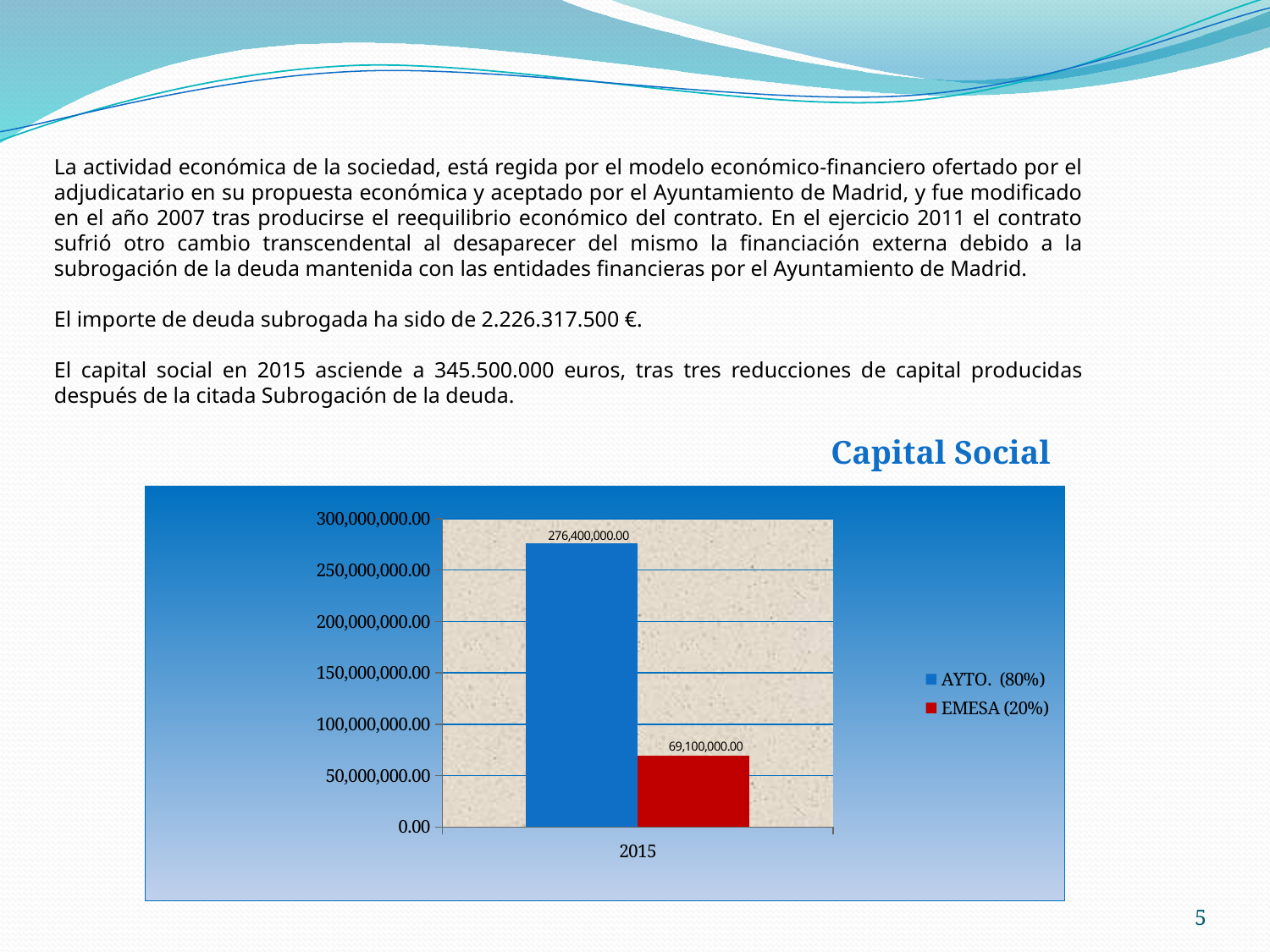
How many categories are shown on the x axis? 1 Is the value for AYTO. (80%) greater or less than 250,000,000.00? greater What is the difference between the AYTO. (80%) value and the EMESA (20%) value in 2015? 207,300,000.00 Which series has the lower value in 2015? EMESA (20%) What kind of chart is shown on the slide? bar chart Is the value for AYTO. (80%) larger or smaller than the value for EMESA (20%)? larger What is the value for EMESA (20%) in 2015? 69,100,000.00 How many series does the legend list? 2 What is the value for AYTO. (80%) in 2015? 276,400,000.00 Is the value for EMESA (20%) greater or less than 100,000,000.00? less What is the title of the chart? Capital Social Which series has the higher value in 2015? AYTO. (80%)